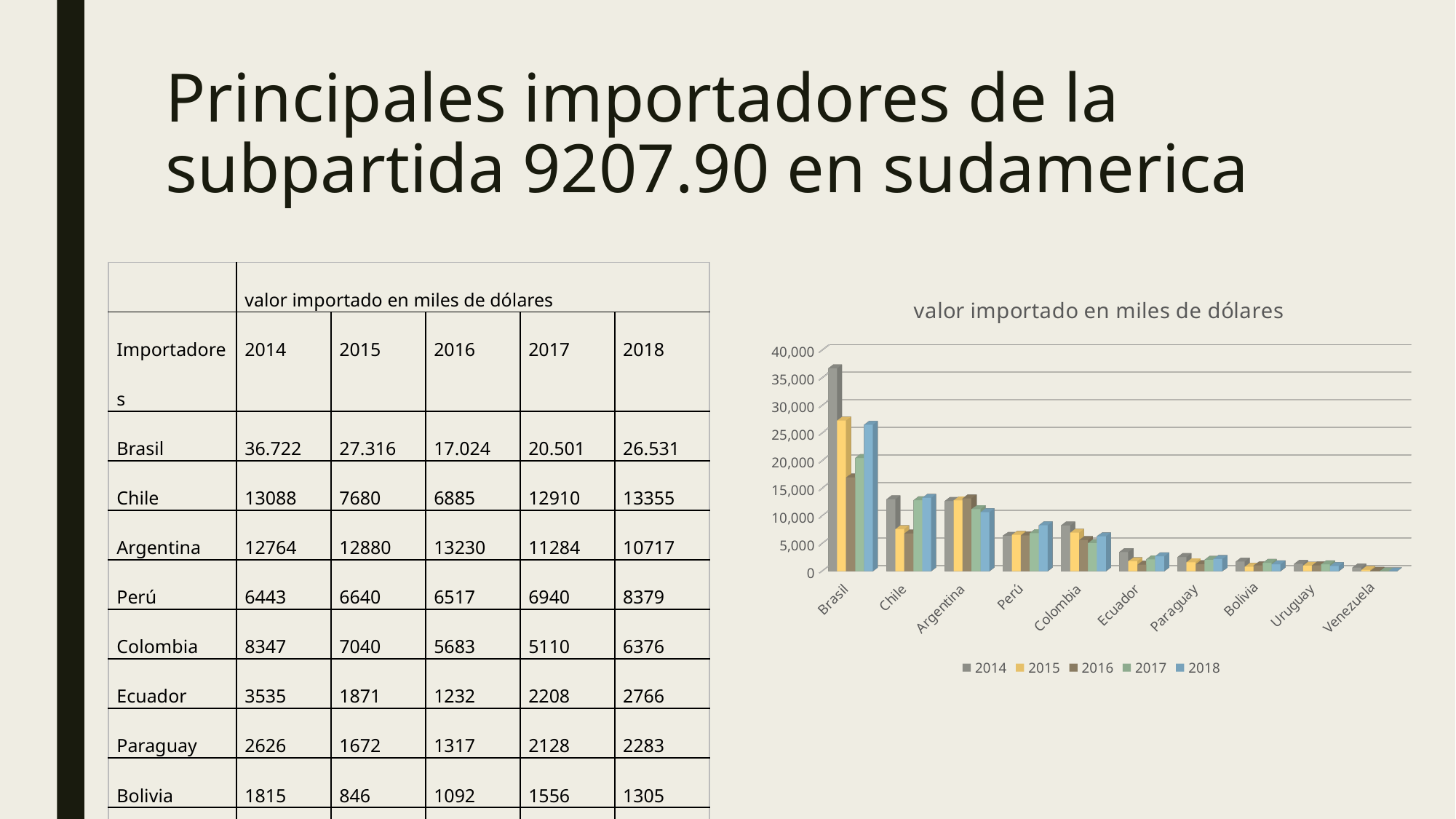
Do the values generally rise or fall moving from Brasil to Venezuela along the x axis? fall Which country has the lowest values in the chart? Venezuela Is the 2014 value for Brasil greater or less than 35,000? greater How many countries are shown on the x axis of the chart? 10 What is the difference between the 2018 and 2017 values for Perú? 1439 How many series does the chart legend list? 5 Is the 2014 value for Ecuador greater or less than 5,000? less What is the 2016 value for Argentina? 13230 Which country has the tallest bar in the chart? Brasil What kind of chart is shown on the slide? bar chart What is the title of the chart? valor importado en miles de dólares Which is larger, the 2018 value for Chile or the 2018 value for Argentina? Chile